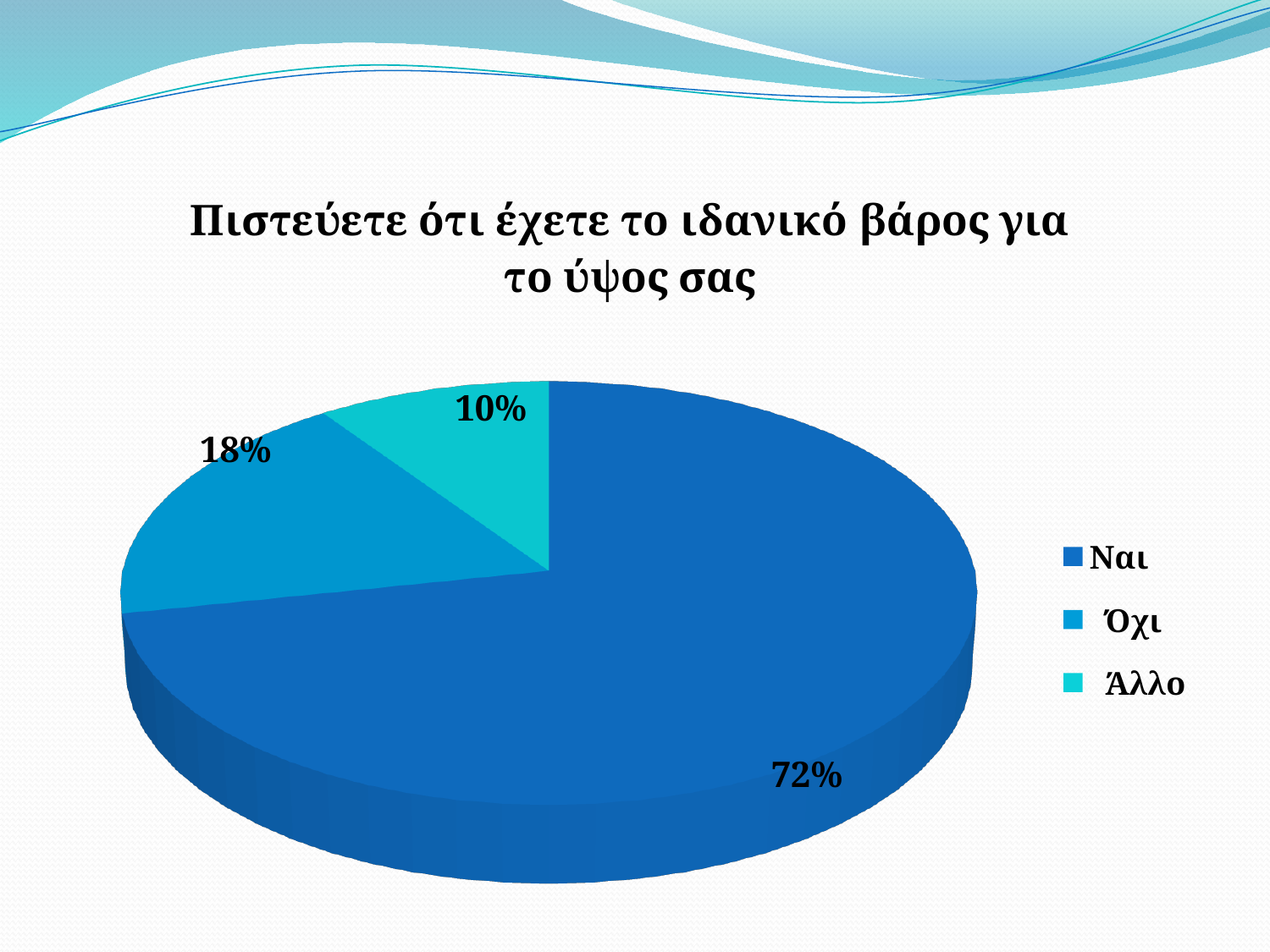
What is the difference in percentage points between the Ναι and Όχι slices? 54 What share of the pie does the Ναι slice represent? 72% Which category has the smallest slice of the pie? Άλλο What is the title of the chart? Πιστεύετε ότι έχετε το ιδανικό βάρος για το ύψος σας What kind of chart is shown on the slide? Pie chart How many entries does the legend list? 3 How many slices does the pie chart have? 3 What share of the pie does the Άλλο slice represent? 10% What share of the pie does the Όχι slice represent? 18% What is the difference in percentage points between the Όχι and Άλλο slices? 8 Which slice is larger, Όχι or Άλλο? Όχι Which category has the largest slice of the pie? Ναι